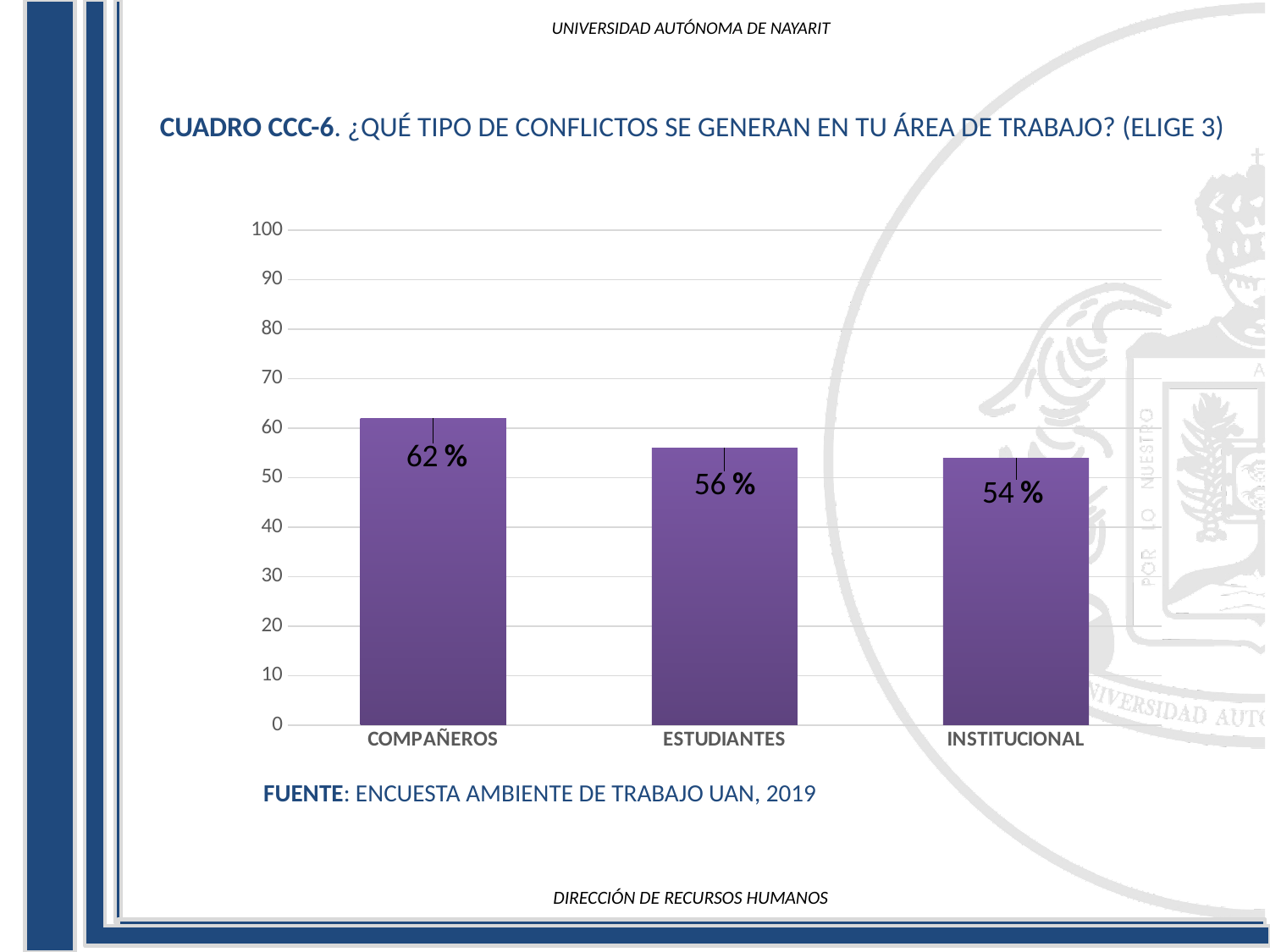
What is the difference between the values for COMPAÑEROS and ESTUDIANTES? 6 % Do the values rise or fall from left to right across the categories? fall What is the value for COMPAÑEROS? 62 % What is the value for ESTUDIANTES? 56 % What is the difference between the values for COMPAÑEROS and INSTITUCIONAL? 8 % Is the value for COMPAÑEROS greater or less than 60? greater How many categories are shown in the chart? 3 Which category has the lowest value? INSTITUCIONAL Which category has the highest value? COMPAÑEROS Which is larger, the value for ESTUDIANTES or the value for INSTITUCIONAL? ESTUDIANTES What is the value for INSTITUCIONAL? 54 % What kind of chart is shown on the slide? bar chart